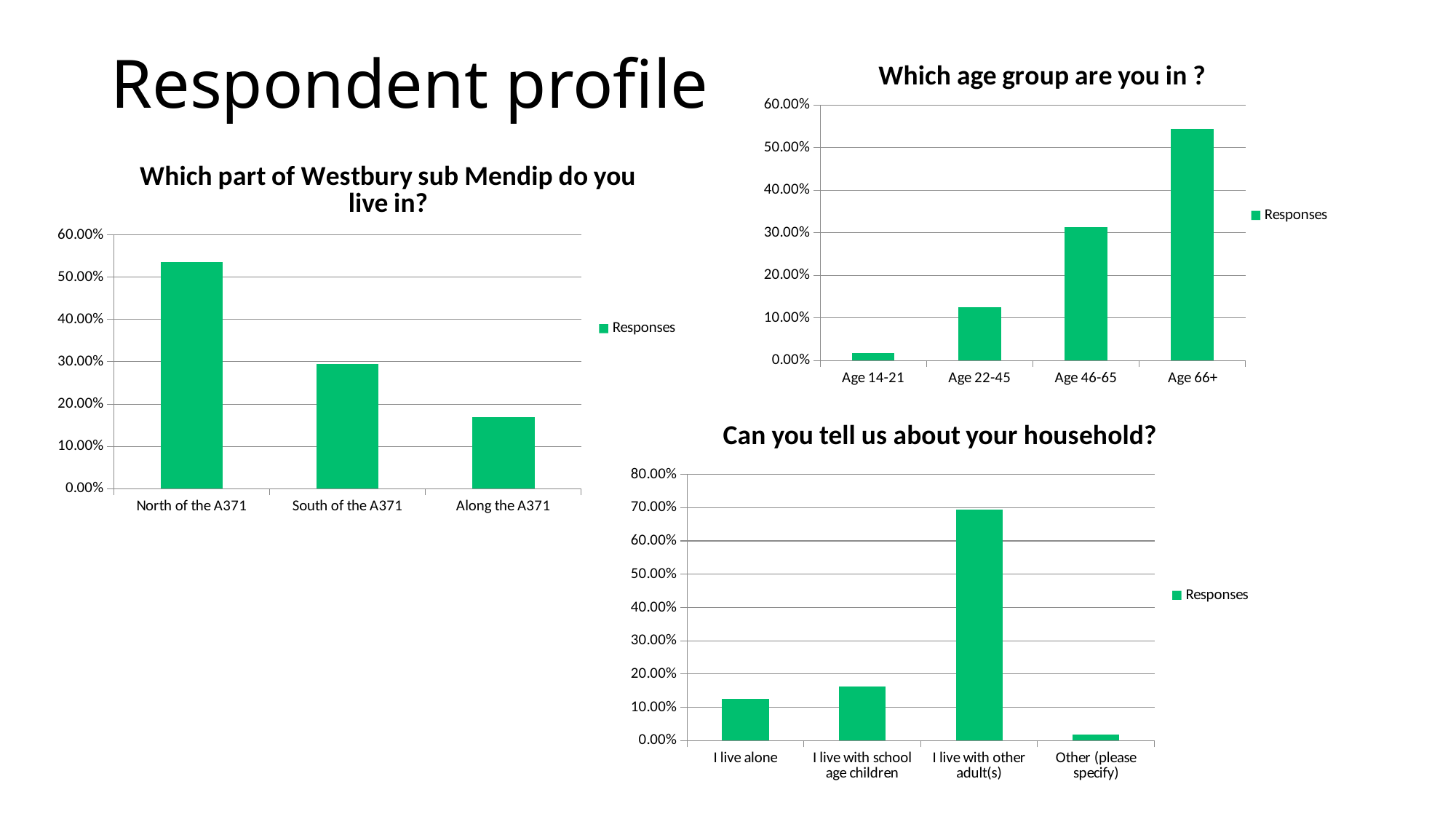
In the chart 'Can you tell us about your household?', is the value for I live with other adult(s) greater or less than 60.00%? greater In the chart 'Which age group are you in ?', which age group has the lowest value? Age 14-21 In the chart 'Can you tell us about your household?', which is larger: I live alone or I live with school age children? I live with school age children In the chart 'Which part of Westbury sub Mendip do you live in?', is the value for North of the A371 greater or less than 50.00%? greater In the chart 'Which part of Westbury sub Mendip do you live in?', which category has the highest value? North of the A371 In the chart 'Which age group are you in ?', which age group has the highest value? Age 66+ In the chart 'Which age group are you in ?', do the values rise or fall from Age 14-21 to Age 66+? rise In the chart 'Can you tell us about your household?', which category has the highest value? I live with other adult(s) In the chart 'Which part of Westbury sub Mendip do you live in?', how many categories are shown on the x axis? 3 In the chart 'Which part of Westbury sub Mendip do you live in?', which category has the lowest value? Along the A371 In the chart 'Which age group are you in ?', is the value for Age 46-65 greater or less than 30.00%? greater What type of chart is 'Can you tell us about your household?'? bar chart